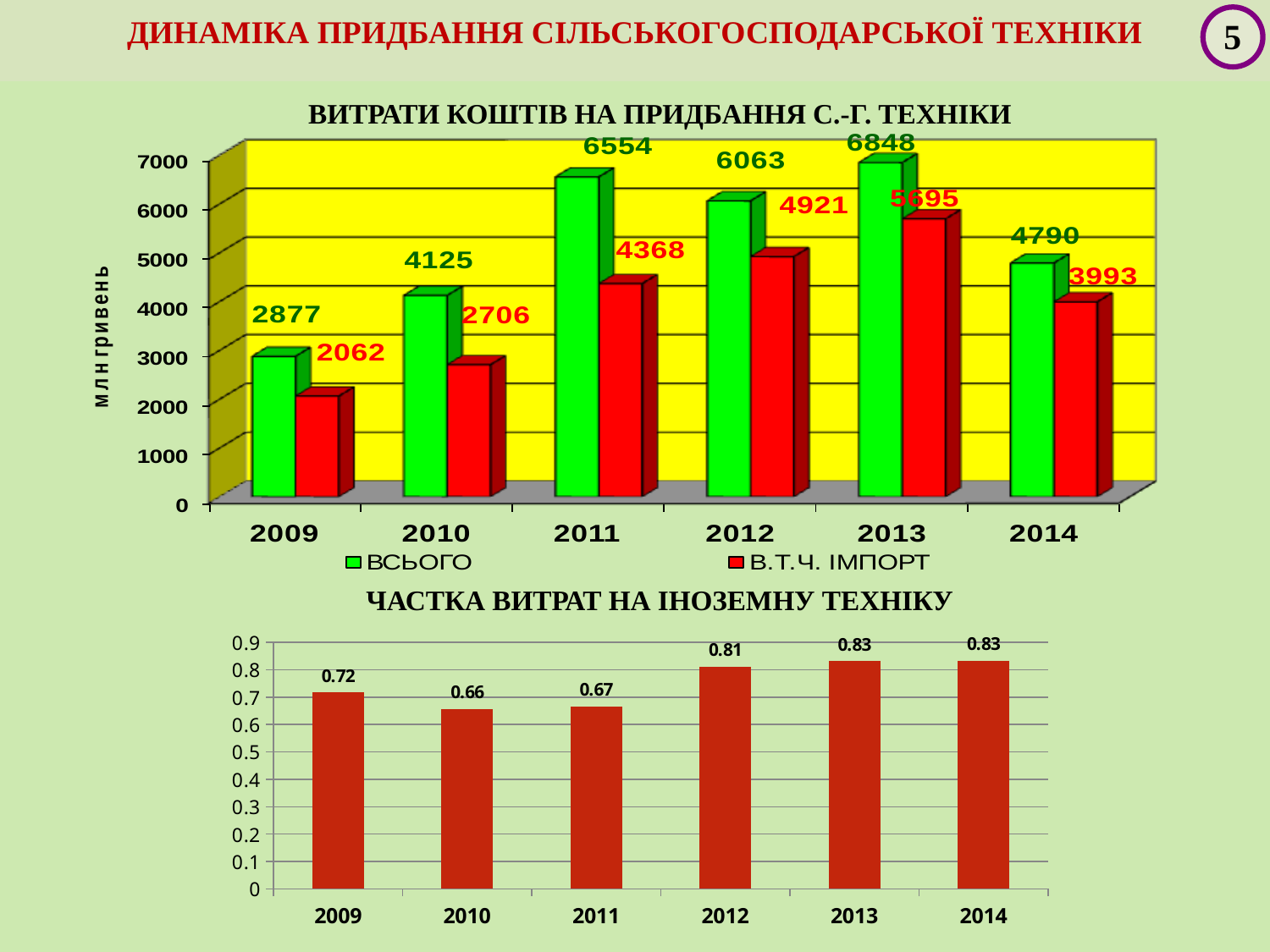
In the bottom chart (ЧАСТКА ВИТРАТ НА ІНОЗЕМНУ ТЕХНІКУ), which year has the lowest value? 2010 In the top chart (ВИТРАТИ КОШТІВ НА ПРИДБАННЯ С.-Г. ТЕХНІКИ), which year has the highest ВСЬОГО value? 2013 In the bottom chart (ЧАСТКА ВИТРАТ НА ІНОЗЕМНУ ТЕХНІКУ), what is the value for 2012? 0.81 In the top chart (ВИТРАТИ КОШТІВ НА ПРИДБАННЯ С.-Г. ТЕХНІКИ), what is the В.Т.Ч. ІМПОРТ value for 2013? 5695 What kind of chart is the bottom chart (ЧАСТКА ВИТРАТ НА ІНОЗЕМНУ ТЕХНІКУ)? Bar chart What is the y-axis label of the top chart (ВИТРАТИ КОШТІВ НА ПРИДБАННЯ С.-Г. ТЕХНІКИ)? млн гривень How many years are shown on the x axis of the bottom chart (ЧАСТКА ВИТРАТ НА ІНОЗЕМНУ ТЕХНІКУ)? 6 In the top chart (ВИТРАТИ КОШТІВ НА ПРИДБАННЯ С.-Г. ТЕХНІКИ), which is larger: the ВСЬОГО value for 2010 or the ВСЬОГО value for 2014? 2014 How many series does the legend of the top chart (ВИТРАТИ КОШТІВ НА ПРИДБАННЯ С.-Г. ТЕХНІКИ) list? 2 In the top chart (ВИТРАТИ КОШТІВ НА ПРИДБАННЯ С.-Г. ТЕХНІКИ), what is the ВСЬОГО value for 2011? 6554 In the top chart (ВИТРАТИ КОШТІВ НА ПРИДБАННЯ С.-Г. ТЕХНІКИ), what is the difference between the ВСЬОГО and В.Т.Ч. ІМПОРТ values for 2012? 1142 In the top chart (ВИТРАТИ КОШТІВ НА ПРИДБАННЯ С.-Г. ТЕХНІКИ), which year has the lowest В.Т.Ч. ІМПОРТ value? 2009